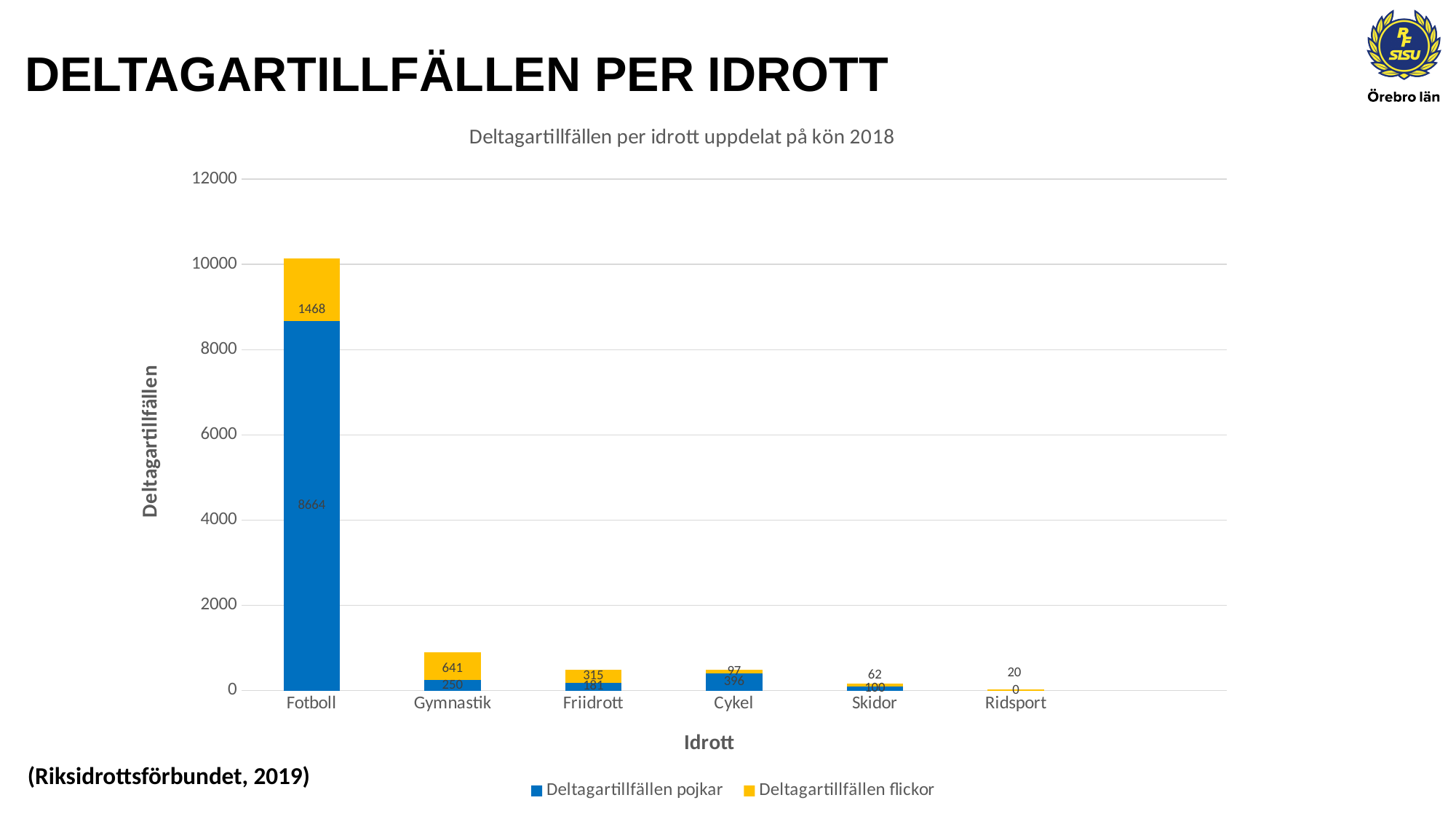
What is the value for Deltagartillfällen flickor for Gymnastik? 641 What kind of chart is shown on the slide? Stacked bar chart What is the value for Deltagartillfällen flickor for Fotboll? 1468 What is the total of the stacked bar for Fotboll? 10132 How many series does the legend list? 2 For Gymnastik, which is larger: Deltagartillfällen pojkar or Deltagartillfällen flickor? Deltagartillfällen flickor How many sports are shown on the x axis? 6 Which sport has the highest total number of deltagartillfällen? Fotboll What is the value for Deltagartillfällen pojkar for Fotboll? 8664 What is the difference between Deltagartillfällen pojkar and Deltagartillfällen flickor for Fotboll? 7196 What is the value for Deltagartillfällen pojkar for Cykel? 396 What is the value for Deltagartillfällen flickor for Ridsport? 20